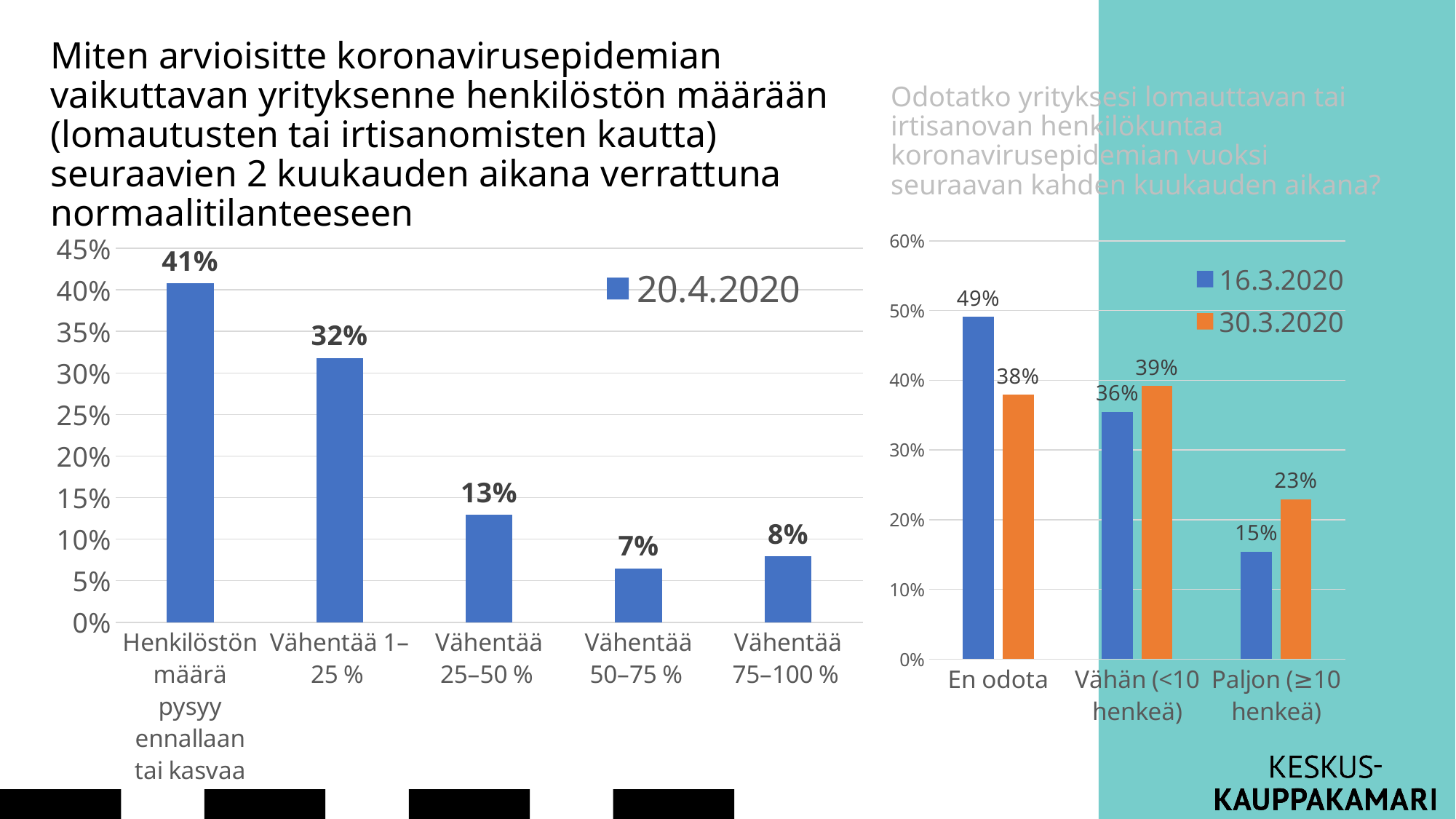
In the right chart, what is the difference between the 16.3.2020 and 30.3.2020 values for 'En odota'? 11% In the left chart, which category has the highest value? Henkilöstön määrä pysyy ennallaan tai kasvaa In the right chart, what is the value for 'En odota' in the 30.3.2020 series? 38% In the left chart, what is the value for 'Vähentää 1–25 %'? 32% In the right chart, which is larger for 'Vähän (<10 henkeä)': 16.3.2020 or 30.3.2020? 30.3.2020 In the right chart, what is the value for 'Paljon (≥10 henkeä)' in the 16.3.2020 series? 15% How many categories does the left chart show? 5 What kind of chart is the left chart? Bar chart In the left chart, which category has the lowest value? Vähentää 50–75 % How many series does the legend of the right chart list? 2 In the right chart, which series is shown in orange? 30.3.2020 In the left chart, what is the difference between 'Vähentää 25–50 %' and 'Vähentää 75–100 %'? 5%